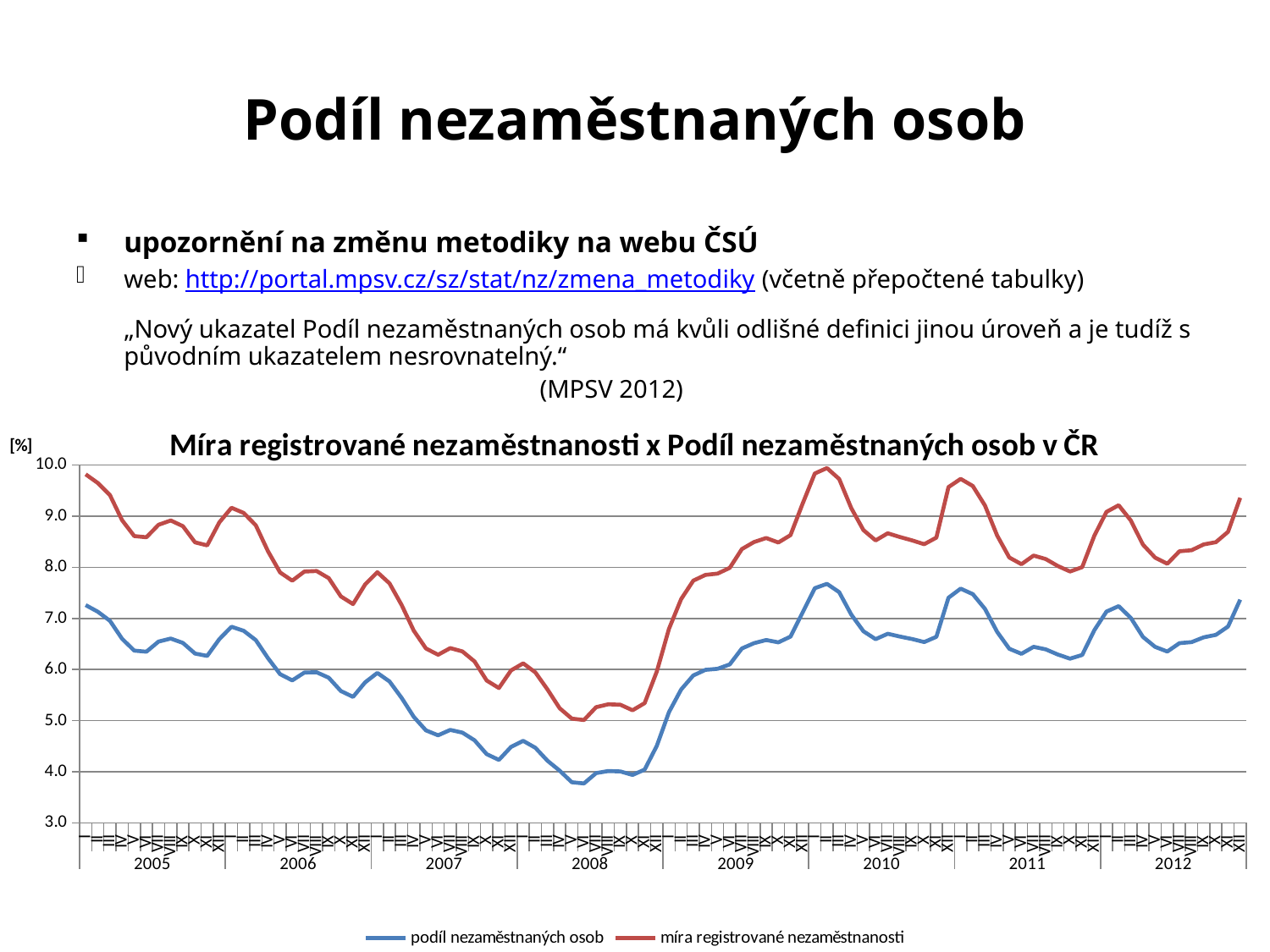
Do the values of míra registrované nezaměstnanosti rise or fall during 2008 into 2009? rise Do the values of podíl nezaměstnaných osob rise or fall from the start of 2005 to the start of 2008? fall Is the value of podíl nezaměstnaných osob at the start of 2008 greater or less than 5.0? less How many years are labelled along the x axis of the chart? 8 How many series does the legend of the chart list? 2 Is the highest value of míra registrované nezaměstnanosti in 2009 greater or less than 9.0? greater Is the value of míra registrované nezaměstnanosti at the start of 2005 greater or less than 9.0? greater What is the title of the chart? Míra registrované nezaměstnanosti x Podíl nezaměstnaných osob v ČR In which year does the podíl nezaměstnaných osob line reach its lowest point? 2008 Which series is drawn in red in the chart? míra registrované nezaměstnanosti Which series has the higher values throughout the chart, podíl nezaměstnaných osob or míra registrované nezaměstnanosti? míra registrované nezaměstnanosti What kind of chart is shown on the slide? line chart